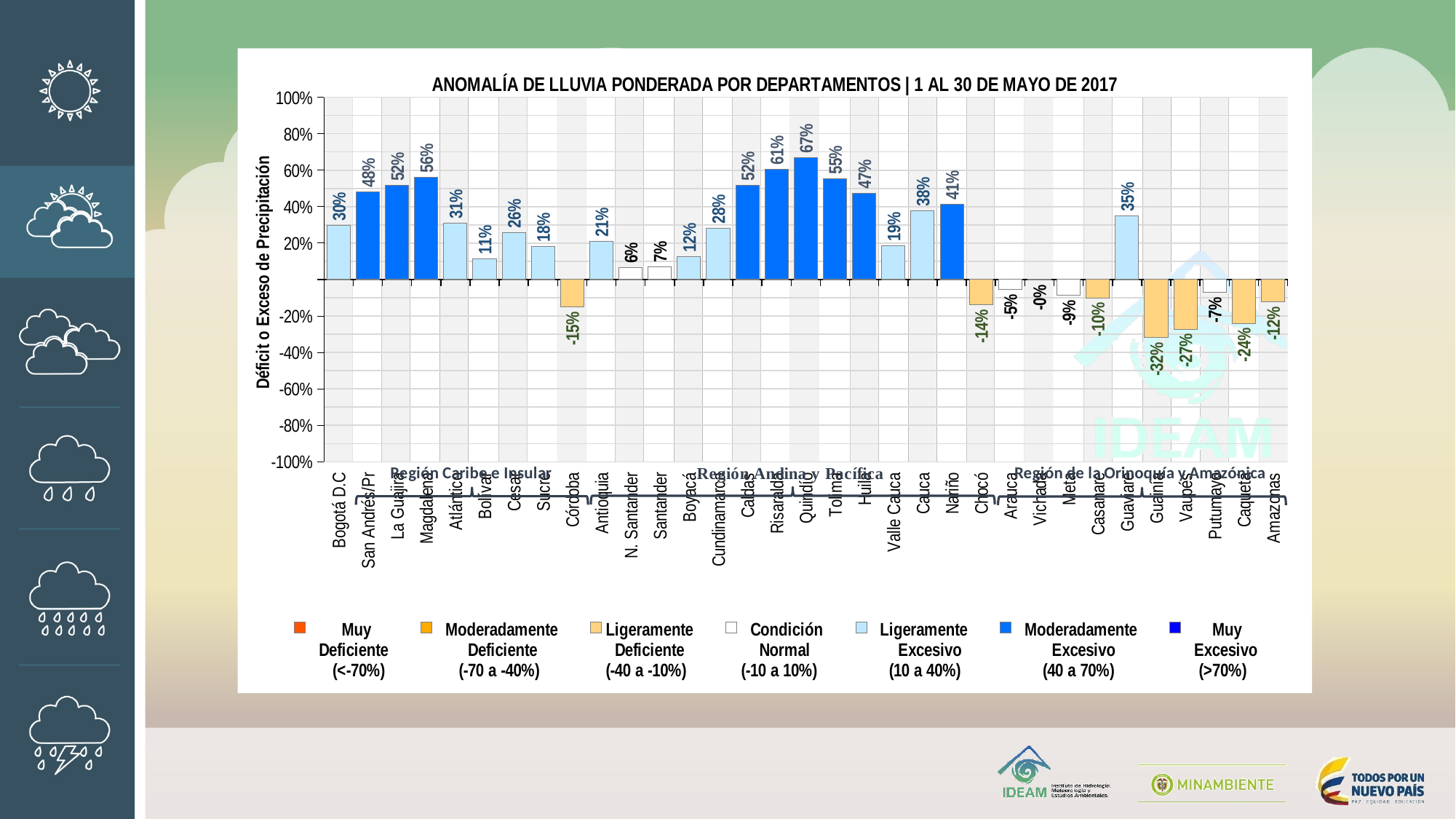
How many departments are shown on the x axis? 33 What is the value for Quindío? 67% What kind of chart is this? Bar chart Which department has the lowest value? Guainía What is the difference between the values for Risaralda and Caldas? 9% Which is larger, the value for Cauca or the value for Nariño? Nariño What is the value for Magdalena? 56% Which department has the highest value? Quindío What is the value for Guainía? -32% What is the value for Córdoba? -15% What is the title of the chart? ANOMALÍA DE LLUVIA PONDERADA POR DEPARTAMENTOS | 1 AL 30 DE MAYO DE 2017 How many categories does the legend list? 7